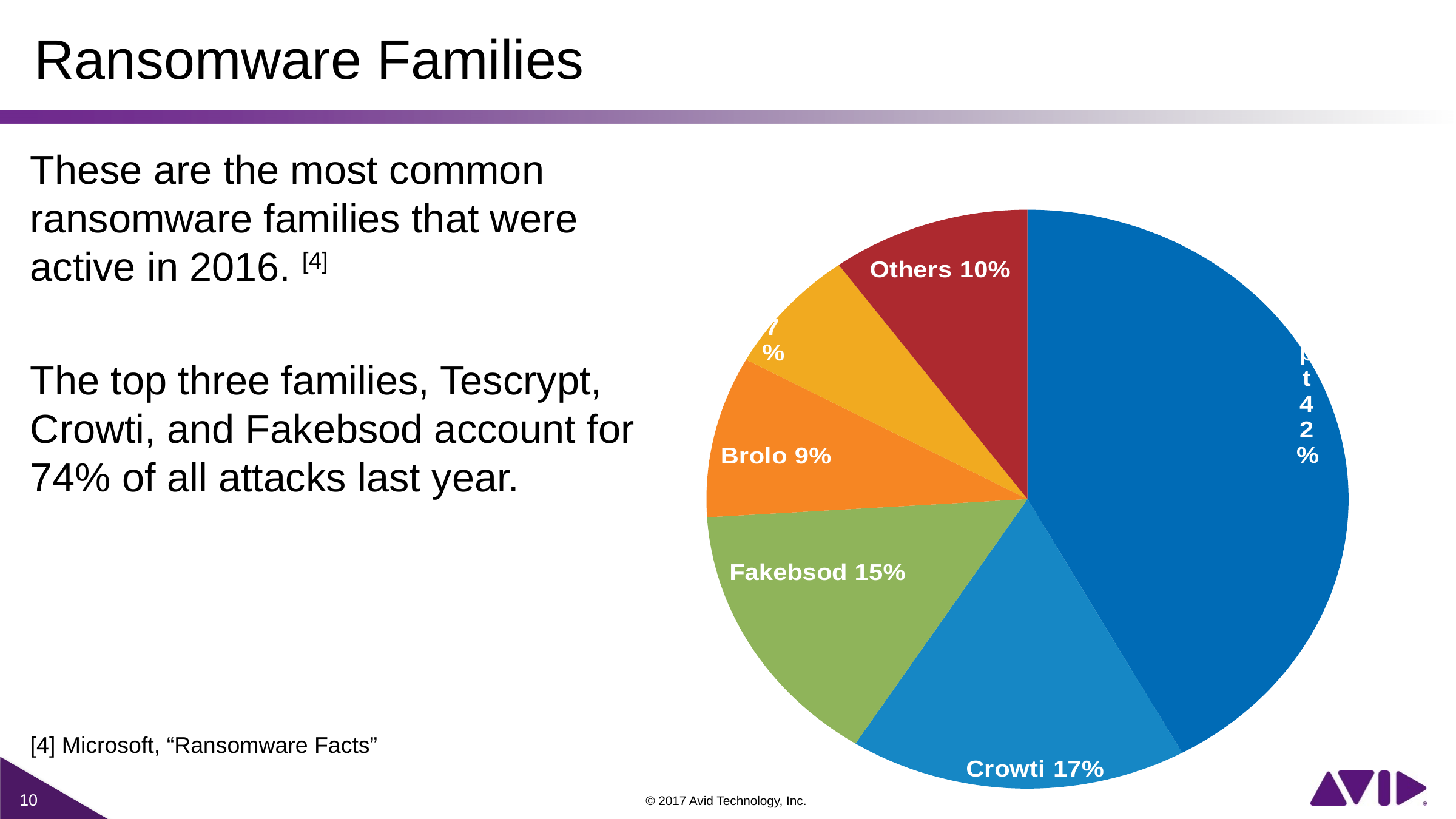
What colour is the Fakebsod slice? green What is the difference in percentage points between Crowti and Fakebsod? 2% What percentage is shown on the largest slice of the pie? 42% What percentage of the pie does Brolo account for? 9% What percentage of the pie does Fakebsod account for? 15% How many slices does the pie chart have? 6 What is the difference in percentage points between Crowti and Brolo? 8% Which slice of the pie is the largest? Tescrypt What share of the pie is labelled Others? 10% What percentage of the pie does Crowti account for? 17% What kind of chart is shown on the slide? pie chart Which is larger, the Fakebsod slice or the Others slice? Fakebsod